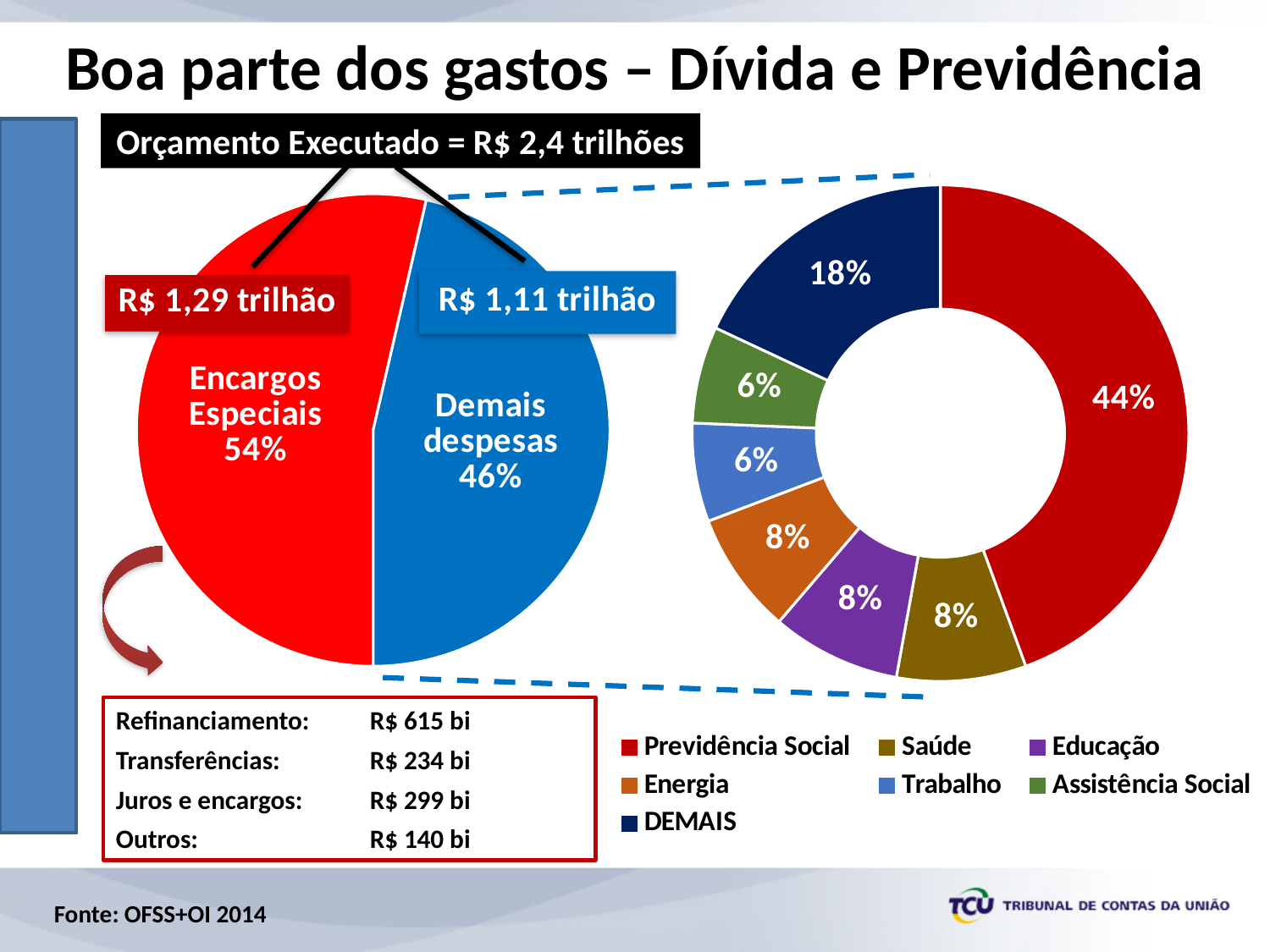
In the left pie chart, what share is labelled for Demais despesas? 46% In the right doughnut chart, which category has the largest share? Previdência Social In the right doughnut chart, what percentage is shown for DEMAIS? 18% In the right doughnut chart, what is the difference in percentage points between Previdência Social and DEMAIS? 26 What type of chart is the chart on the left of the slide? Pie chart In the left pie chart, what value in trilhão is shown for Encargos Especiais? R$ 1,29 trilhão In the left pie chart, what share is labelled for Encargos Especiais? 54% In the left pie chart, what value in trilhão is shown for Demais despesas? R$ 1,11 trilhão In the right doughnut chart, what percentage is shown for Trabalho? 6% In the right doughnut chart, what percentage is shown for Previdência Social? 44% How many categories does the legend of the right doughnut chart list? 7 In the left pie chart, which slice is larger, Encargos Especiais or Demais despesas? Encargos Especiais